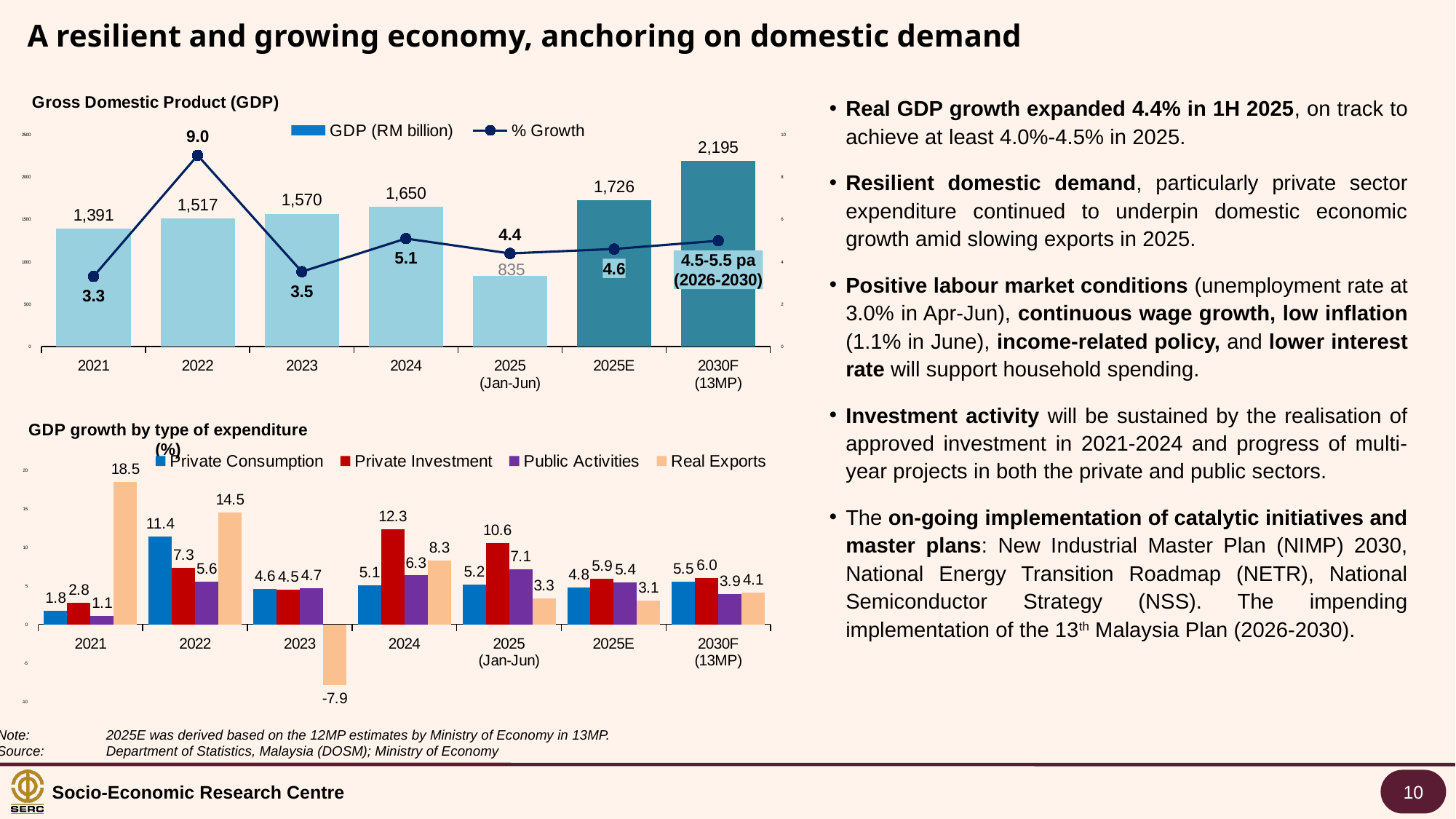
In the Gross Domestic Product (GDP) chart, what is the % Growth value for 2022? 9.0 In the GDP growth by type of expenditure (%) chart, how many series does the legend list? 4 In the GDP growth by type of expenditure (%) chart, what is the difference between Real Exports in 2021 and Real Exports in 2022? 4.0 In the Gross Domestic Product (GDP) chart, what is the GDP (RM billion) value for 2024? 1,650 In the Gross Domestic Product (GDP) chart, what is the difference in GDP (RM billion) between 2030F (13MP) and 2025E? 469 In the Gross Domestic Product (GDP) chart, what is the GDP (RM billion) value for 2025 (Jan-Jun)? 835 In the GDP growth by type of expenditure (%) chart, which year has the lowest Real Exports value? 2023 In the Gross Domestic Product (GDP) chart, which year has the highest % Growth? 2022 What type of chart is the GDP growth by type of expenditure (%) chart? Bar chart In the Gross Domestic Product (GDP) chart, how many series does the legend list? 2 In the GDP growth by type of expenditure (%) chart, what is the Private Investment value for 2024? 12.3 In the GDP growth by type of expenditure (%) chart, which is larger in 2022: Private Consumption or Private Investment? Private Consumption